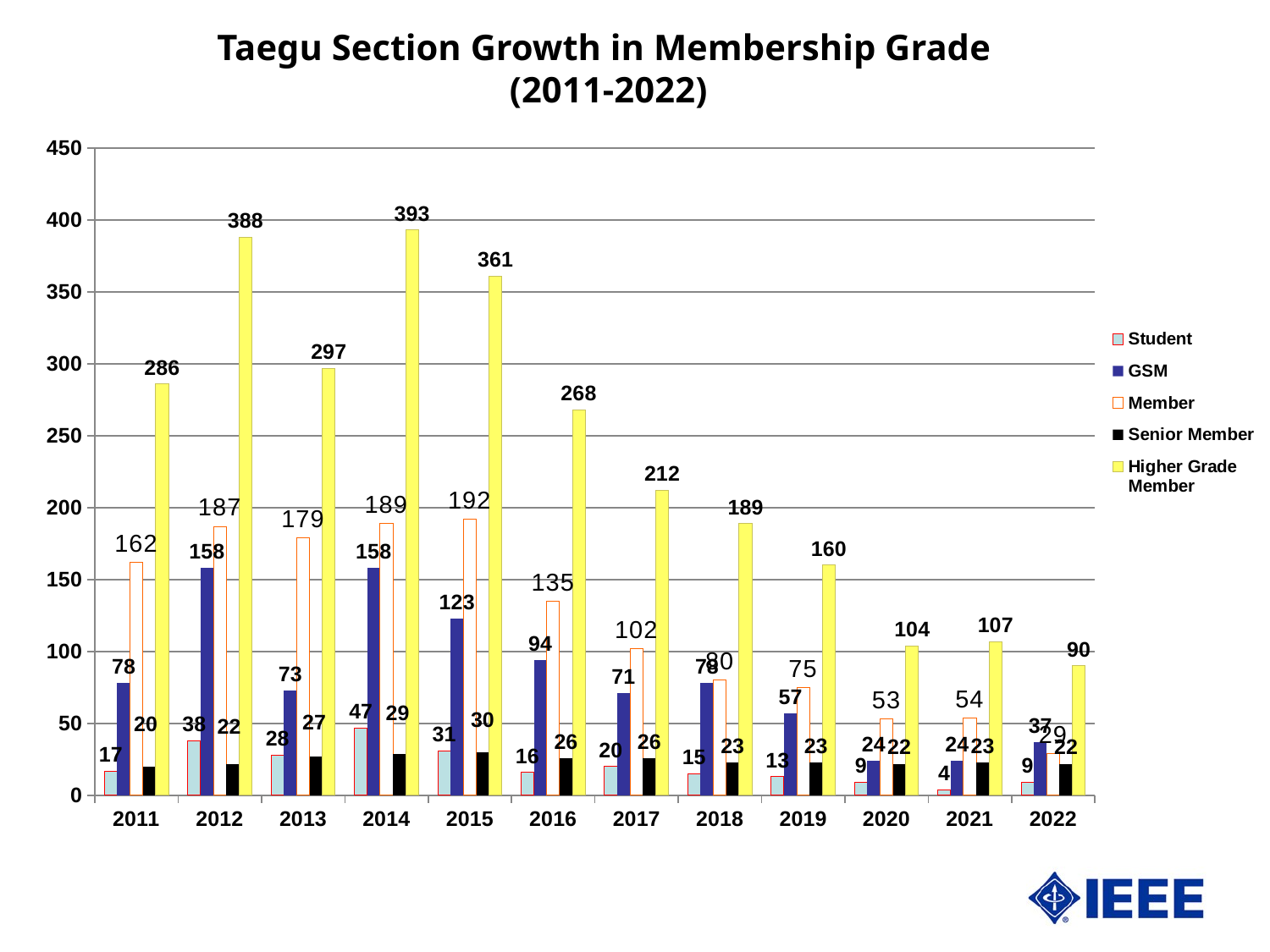
What is the value for Higher Grade Member in 2014? 393 What is the value for Senior Member in 2015? 30 How many years are shown on the x axis? 12 In 2011, which is larger: GSM or Member? Member What is the value for Member in 2015? 192 What kind of chart is shown on the slide? Bar chart In which year is the Student value lowest? 2021 In which year is the Higher Grade Member value highest? 2014 What colour are the Higher Grade Member bars? Yellow What is the difference between the Higher Grade Member values in 2012 and 2022? 298 Do the Higher Grade Member values rise or fall from 2015 to 2022? Fall How many series does the legend list? 5